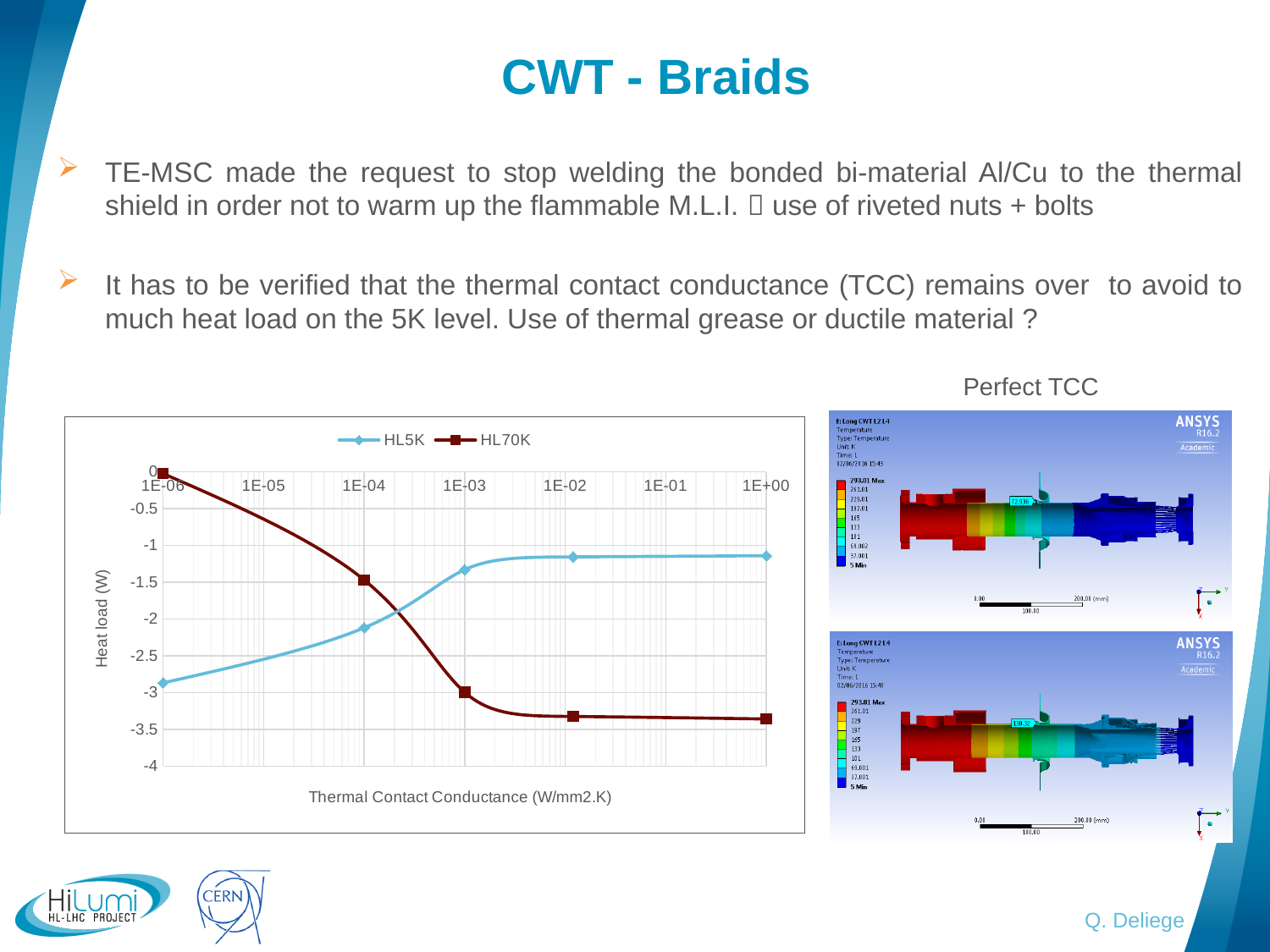
Is the HL5K heat load at 1E-02 W/mm2.K greater or less than -1.5 W? greater At 1E-06 W/mm2.K, which series has the higher heat load, HL5K or HL70K? HL70K What are the names of the two series in the chart legend? HL5K and HL70K Does the HL5K heat load rise or fall as thermal contact conductance increases along the x axis? rise Does the HL70K heat load rise or fall as thermal contact conductance increases along the x axis? fall How many data points are plotted for the HL70K series? 5 At 1E+00 W/mm2.K, which series has the higher heat load, HL5K or HL70K? HL5K How many series does the chart legend list? 2 What is the title of the x axis of the chart? Thermal Contact Conductance (W/mm2.K) Is the HL70K heat load at 1E-03 W/mm2.K greater or less than -2.5 W? less Is the HL5K heat load at 1E-06 W/mm2.K greater or less than -2.5 W? less What kind of chart is shown on the slide? line chart